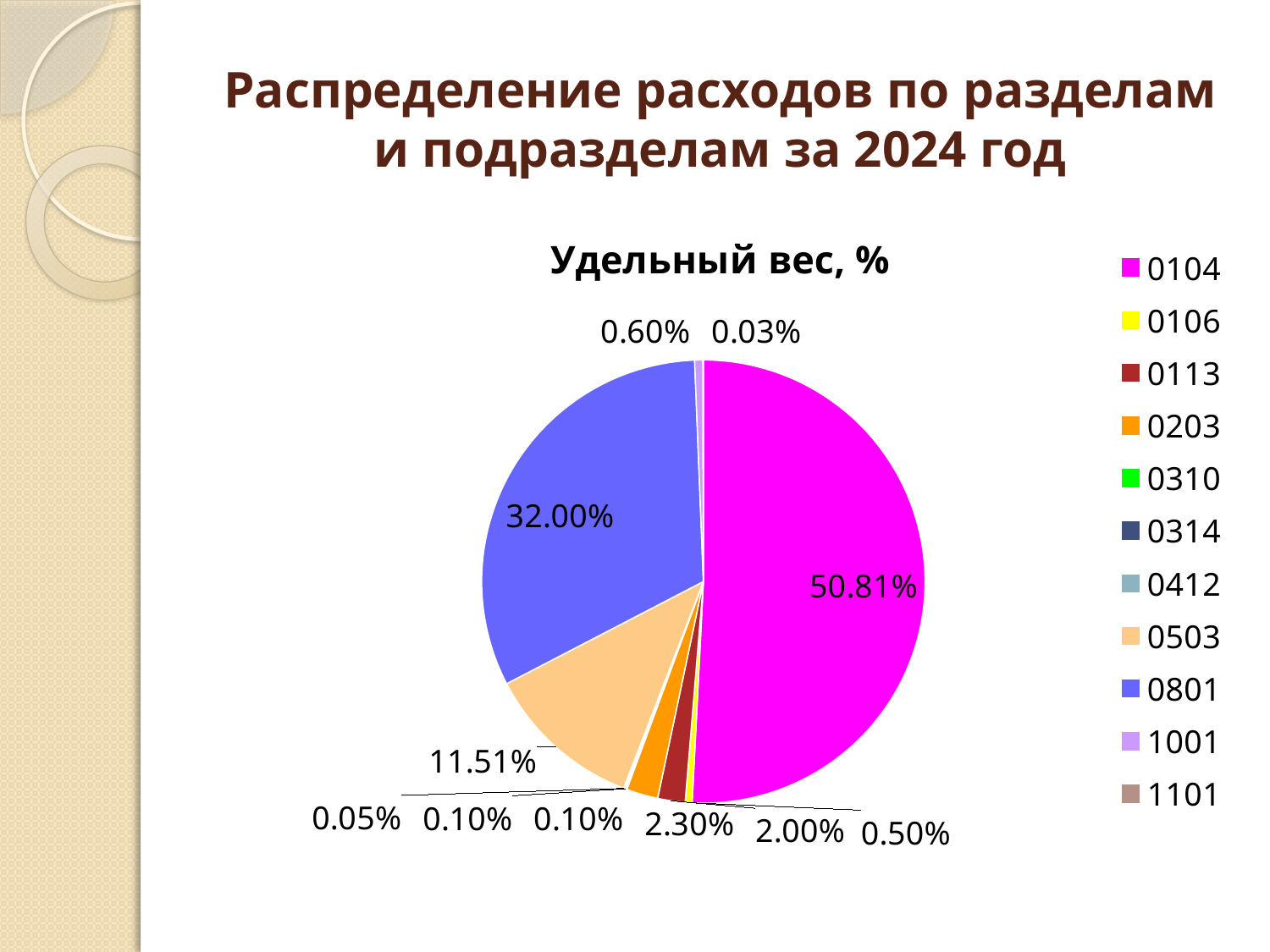
What is the value shown for category 0113? 2.00% What is the value shown for category 0203? 2.30% Which category has the largest slice of the pie? 0104 What is the title of the chart? Удельный вес, % What share of the pie does category 0104 have? 50.81% What is the difference between the values for 0104 and 0801? 18.81% How many categories does the legend list? 11 What kind of chart is shown on the slide? Pie chart What is the value shown for category 0503? 11.51% What is the value shown for category 0801? 32.00% Which category has the smallest slice of the pie? 1101 Which is larger, the slice for 0503 or the slice for 0203? 0503